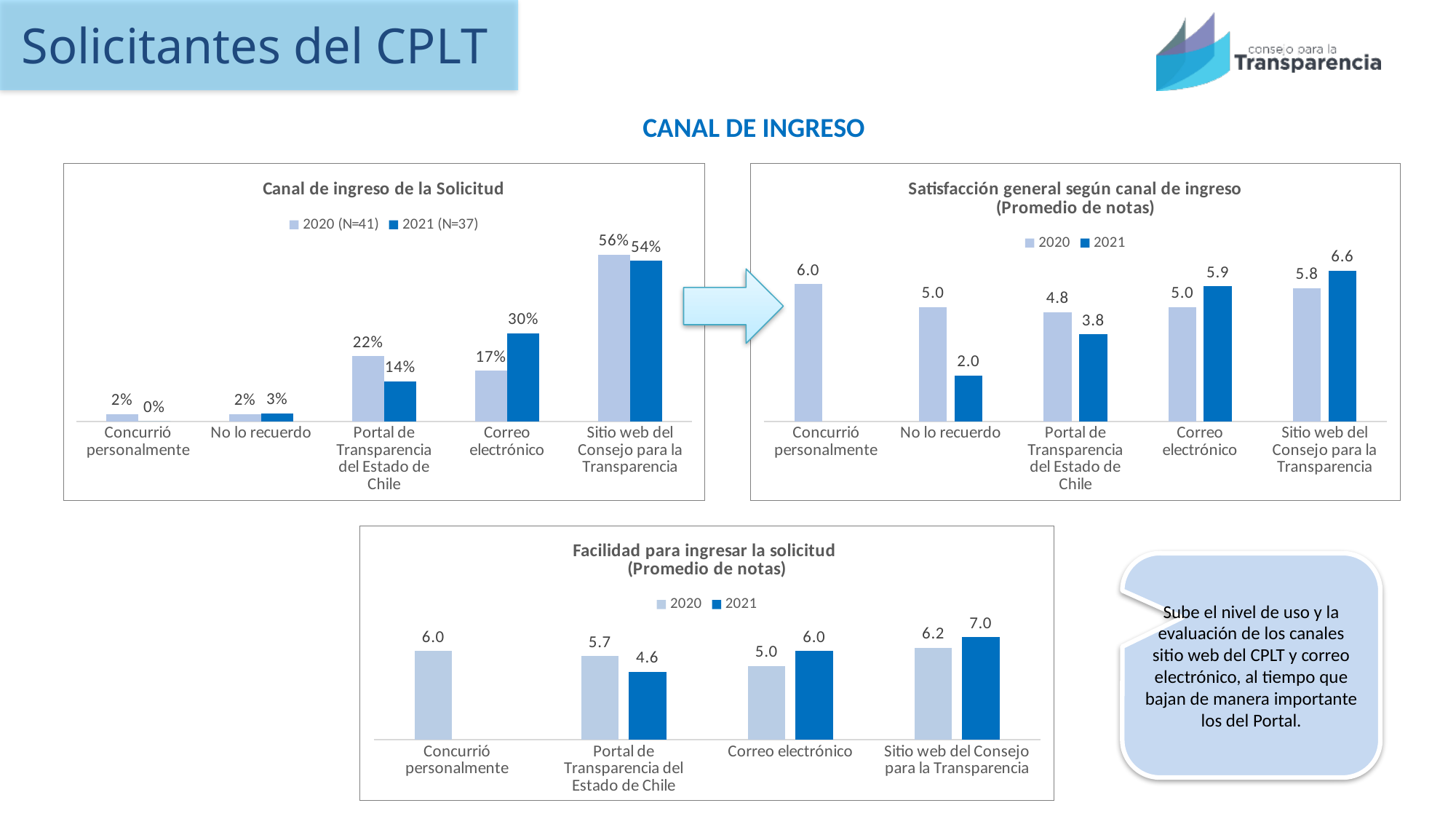
In the chart 'Facilidad para ingresar la solicitud', what is the difference between the 2020 and 2021 values for Portal de Transparencia del Estado de Chile? 1.1 In the chart 'Satisfacción general según canal de ingreso', what is the 2021 value for No lo recuerdo? 2.0 In the chart 'Facilidad para ingresar la solicitud', what is the 2021 value for Sitio web del Consejo para la Transparencia? 7.0 In the chart 'Satisfacción general según canal de ingreso', is the 2021 value for Correo electrónico larger or smaller than the 2020 value? larger In the chart 'Canal de ingreso de la Solicitud', what is the difference between the 2020 and 2021 values for Portal de Transparencia del Estado de Chile? 8% In the chart 'Canal de ingreso de la Solicitud', how many series does the legend list? 2 In the chart 'Facilidad para ingresar la solicitud', how many categories are shown on the x axis? 4 In the chart 'Satisfacción general según canal de ingreso', how many categories are shown on the x axis? 5 In the chart 'Satisfacción general según canal de ingreso', which category has the lowest 2021 value? No lo recuerdo In the chart 'Canal de ingreso de la Solicitud', what is the 2021 (N=37) value for Correo electrónico? 30% What kind of chart is 'Facilidad para ingresar la solicitud'? bar chart In the chart 'Canal de ingreso de la Solicitud', which category has the highest 2020 (N=41) value? Sitio web del Consejo para la Transparencia